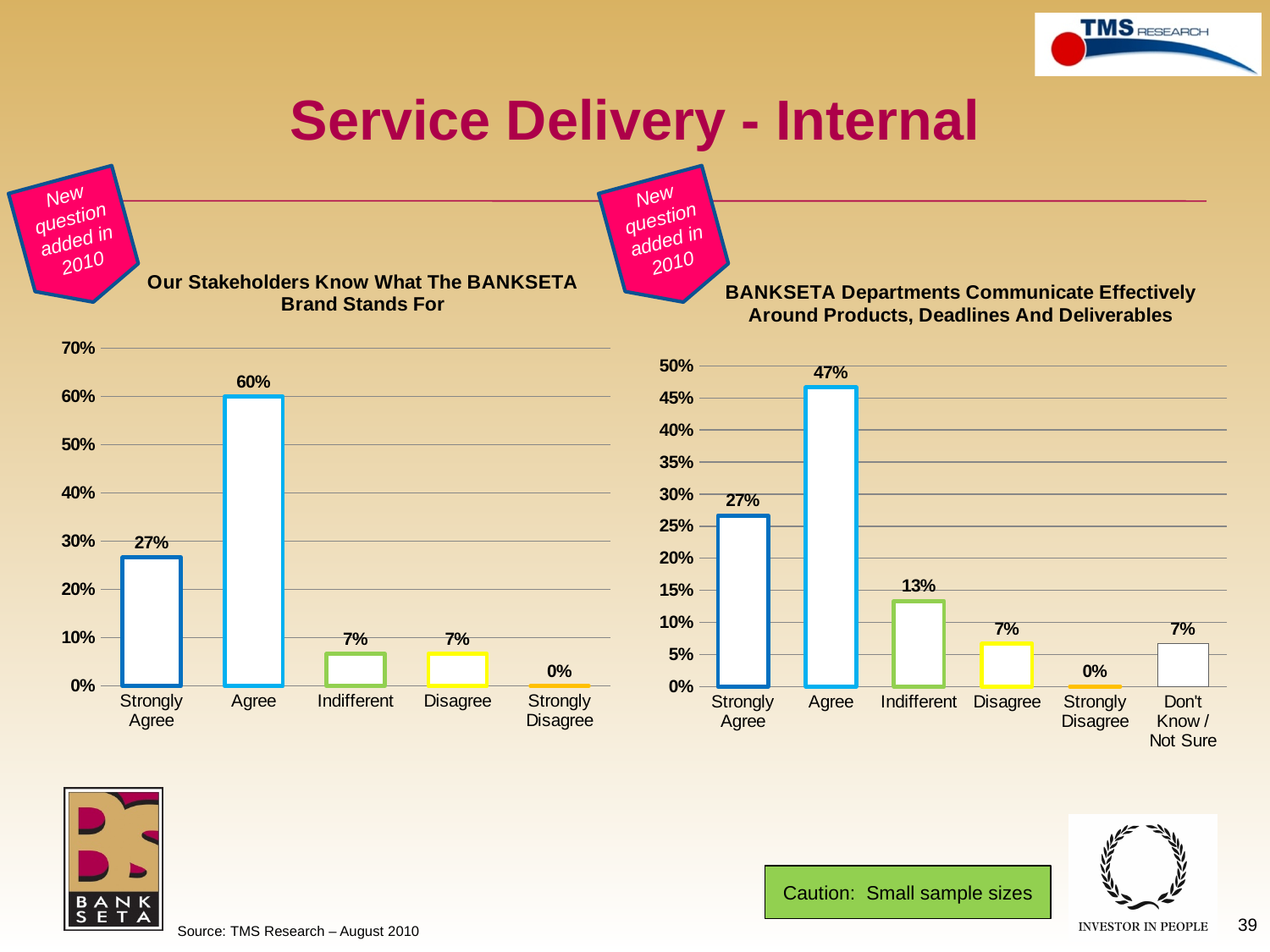
In the chart 'Our Stakeholders Know What The BANKSETA Brand Stands For', what is the value for Agree? 60% In the chart 'Our Stakeholders Know What The BANKSETA Brand Stands For', what is the value for Strongly Agree? 27% How many categories are shown in the chart 'BANKSETA Departments Communicate Effectively Around Products, Deadlines And Deliverables'? 6 In the chart 'Our Stakeholders Know What The BANKSETA Brand Stands For', what is the difference between Agree and Strongly Agree? 33% What type of chart is the chart 'BANKSETA Departments Communicate Effectively Around Products, Deadlines And Deliverables'? Bar chart In the chart 'BANKSETA Departments Communicate Effectively Around Products, Deadlines And Deliverables', what is the value for Indifferent? 13% In the chart 'Our Stakeholders Know What The BANKSETA Brand Stands For', which category has the lowest value? Strongly Disagree How many categories are shown in the chart 'Our Stakeholders Know What The BANKSETA Brand Stands For'? 5 In the chart 'BANKSETA Departments Communicate Effectively Around Products, Deadlines And Deliverables', what is the value for Agree? 47% In the chart 'Our Stakeholders Know What The BANKSETA Brand Stands For', which category has the highest value? Agree In the chart 'BANKSETA Departments Communicate Effectively Around Products, Deadlines And Deliverables', which is larger, Strongly Agree or Indifferent? Strongly Agree In the chart 'BANKSETA Departments Communicate Effectively Around Products, Deadlines And Deliverables', what is the value for Don't Know / Not Sure? 7%